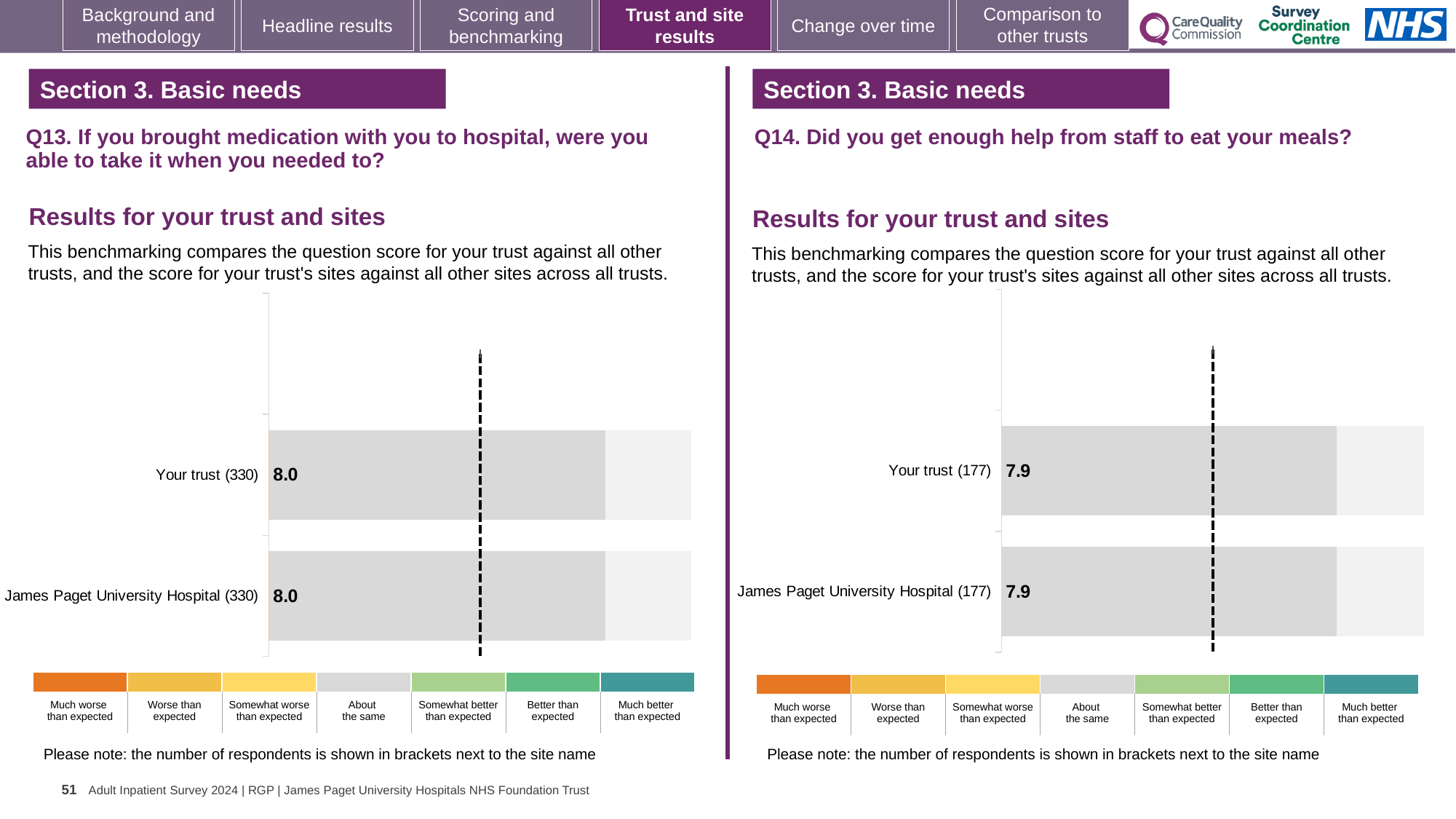
On the Q14 chart (right), how many categories does the colour key below the chart list? 7 On the Q14 chart (right), how many respondents are shown in brackets next to James Paget University Hospital? 177 On the Q13 chart (left), what is the difference between the score for Your trust and the score for James Paget University Hospital? 0.0 On the Q14 chart (right), what is the score for James Paget University Hospital? 7.9 On the Q13 chart (left), what is the score for Your trust? 8.0 On the Q14 chart (right), how many bars are plotted? 2 On the Q13 chart (left), what is the score for James Paget University Hospital? 8.0 What kind of chart is shown on the Q13 chart (left)? Bar chart On the Q13 chart (left), how many respondents are shown in brackets next to Your trust? 330 On the Q14 chart (right), what is the score for Your trust? 7.9 On the Q13 chart (left), how many bars are plotted? 2